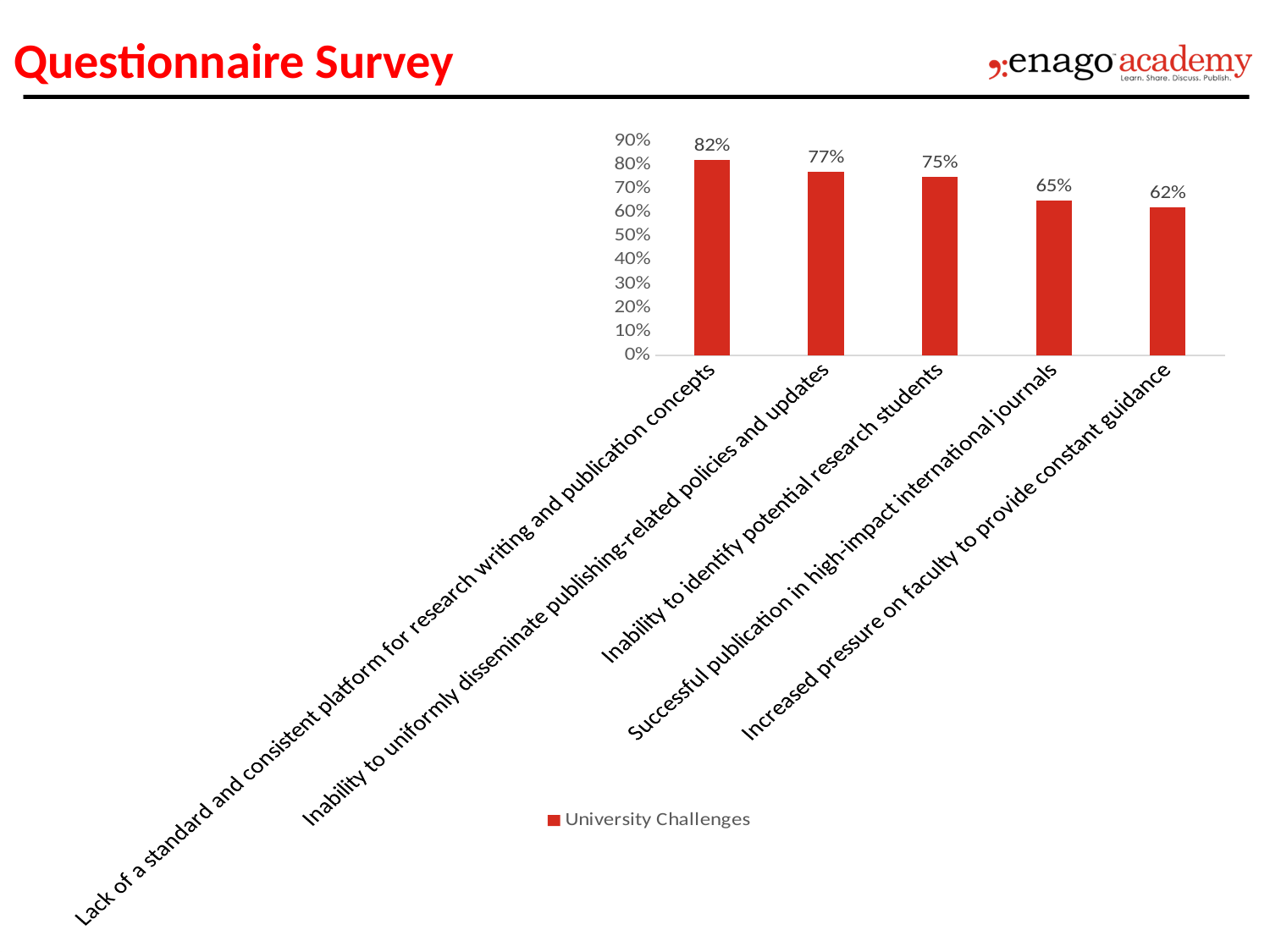
Which is larger: the value for "Inability to identify potential research students" or the value for "Successful publication in high-impact international journals"? Inability to identify potential research students What is the value for "Successful publication in high-impact international journals"? 65% What is the value for "Inability to identify potential research students"? 75% What kind of chart is shown on the slide? bar chart What is the value for "Increased pressure on faculty to provide constant guidance"? 62% What is the name of the series shown in the legend? University Challenges What is the difference between the values for "Lack of a standard and consistent platform for research writing and publication concepts" and "Inability to uniformly disseminate publishing-related policies and updates"? 5% How many series does the legend list? 1 Which category has the lowest value? Increased pressure on faculty to provide constant guidance How many categories are shown in the chart? 5 Which category has the highest value? Lack of a standard and consistent platform for research writing and publication concepts Is the value for "Inability to uniformly disseminate publishing-related policies and updates" greater or less than 70%? greater